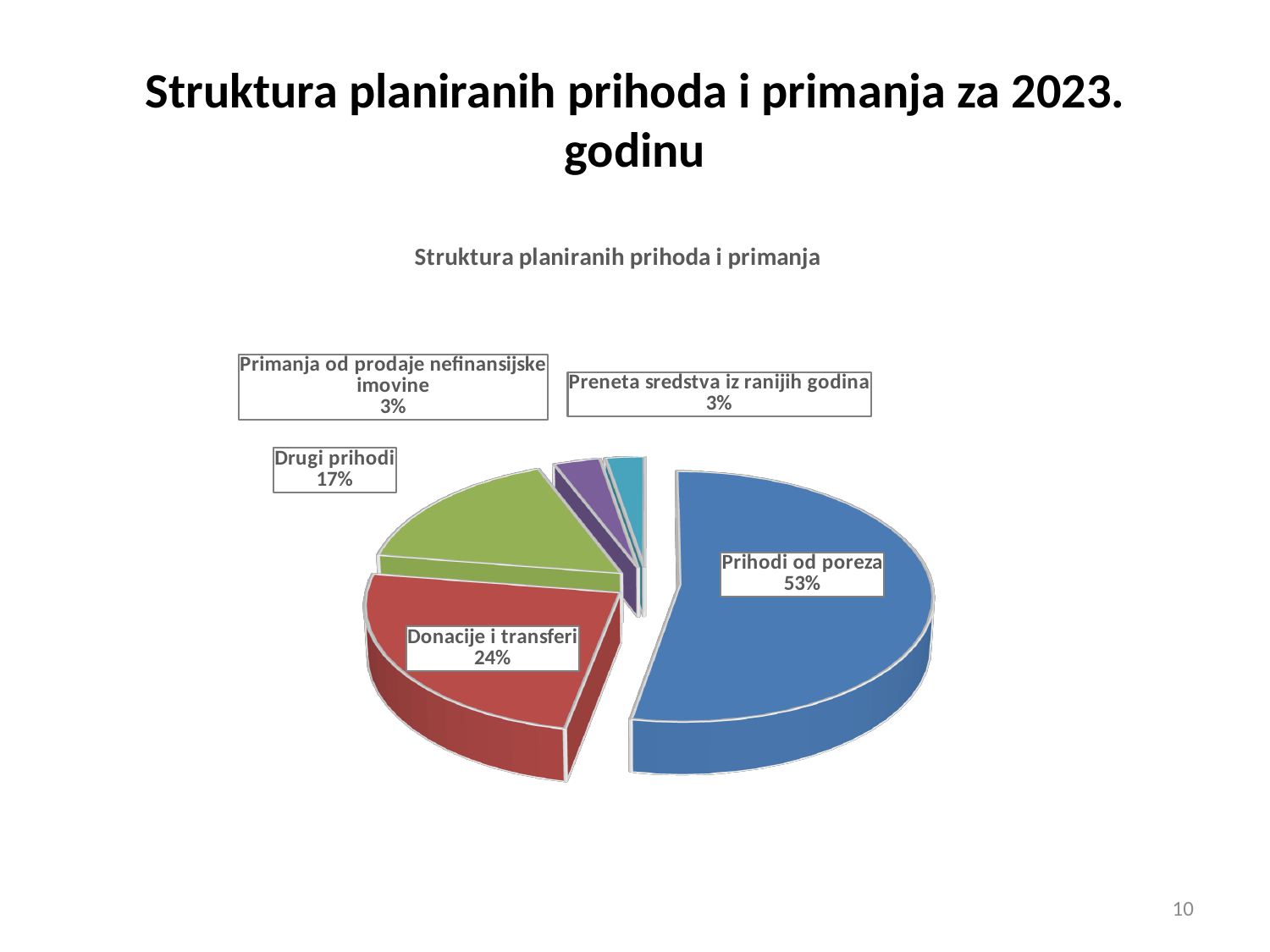
What is the value shown for Drugi prihodi? 17% What kind of chart is shown on the slide? Pie chart What is the value shown for Preneta sredstva iz ranijih godina? 3% How many slices does the pie chart have? 5 What is the value shown for Donacije i transferi? 24% What is the title of the chart? Struktura planiranih prihoda i primanja What is the combined share of Drugi prihodi and Donacije i transferi? 41% What share of the pie does Prihodi od poreza represent? 53% Which is larger, Donacije i transferi or Drugi prihodi? Donacije i transferi What colour is the slice for Prihodi od poreza? Blue What is the difference in percentage points between Prihodi od poreza and Donacije i transferi? 29 Which category has the largest share of the pie? Prihodi od poreza